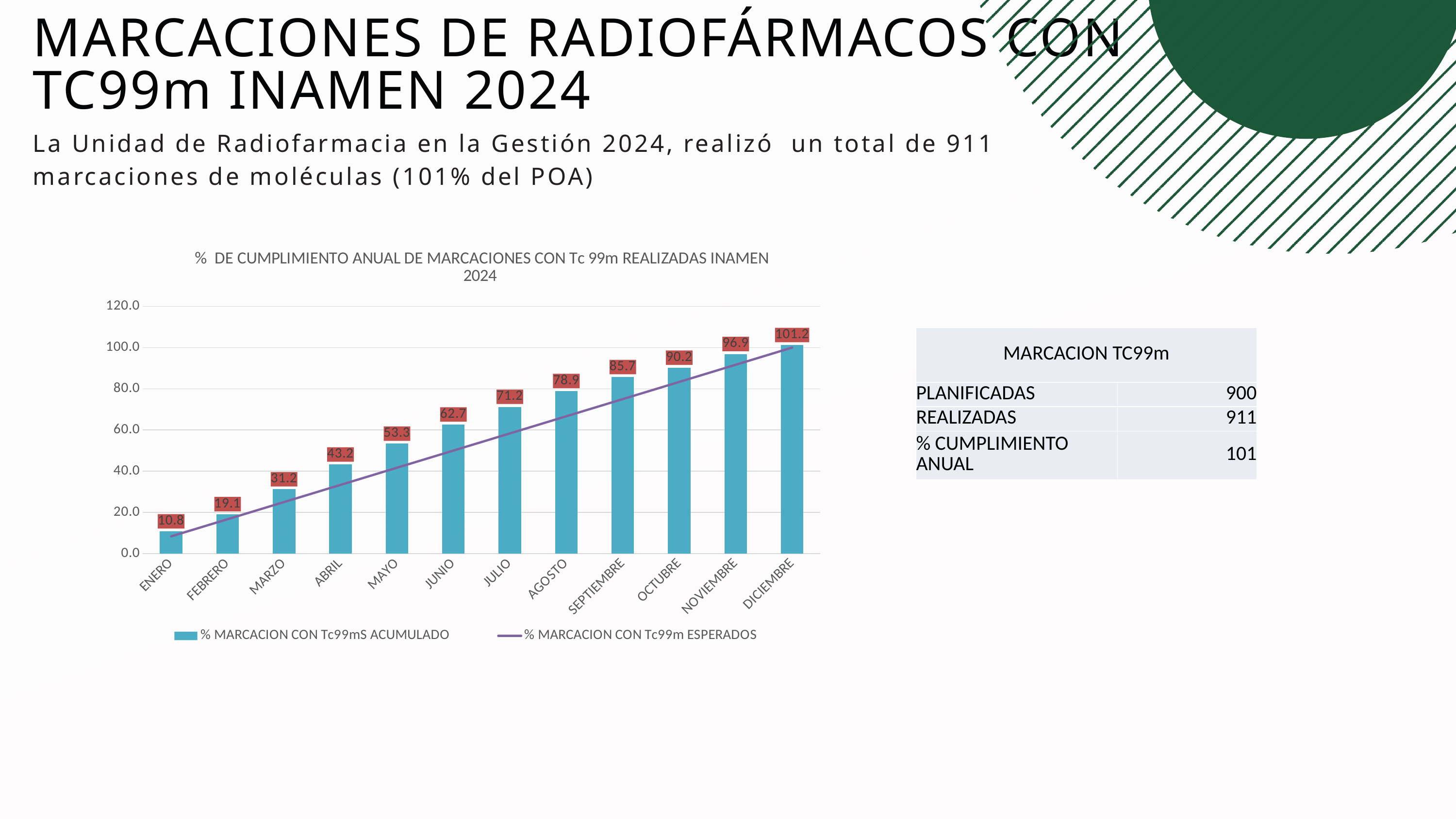
How many series does the chart legend list? 2 What is the value of % MARCACION CON Tc99mS ACUMULADO for JUNIO? 62.7 Which month has the highest % MARCACION CON Tc99mS ACUMULADO? DICIEMBRE What is the value of % MARCACION CON Tc99mS ACUMULADO for ENERO? 10.8 What kind of chart is used to show % MARCACION CON Tc99mS ACUMULADO? Bar chart Which month has the lowest % MARCACION CON Tc99mS ACUMULADO? ENERO Which is larger, the % MARCACION CON Tc99mS ACUMULADO for AGOSTO or for MAYO? AGOSTO What is the value of % MARCACION CON Tc99mS ACUMULADO for DICIEMBRE? 101.2 Is the % MARCACION CON Tc99mS ACUMULADO for OCTUBRE greater or less than 80.0? greater How many months are shown on the x axis of the chart? 12 Do the % MARCACION CON Tc99mS ACUMULADO values rise or fall from ENERO to DICIEMBRE? Rise What is the difference between the % MARCACION CON Tc99mS ACUMULADO values for DICIEMBRE and NOVIEMBRE? 4.3